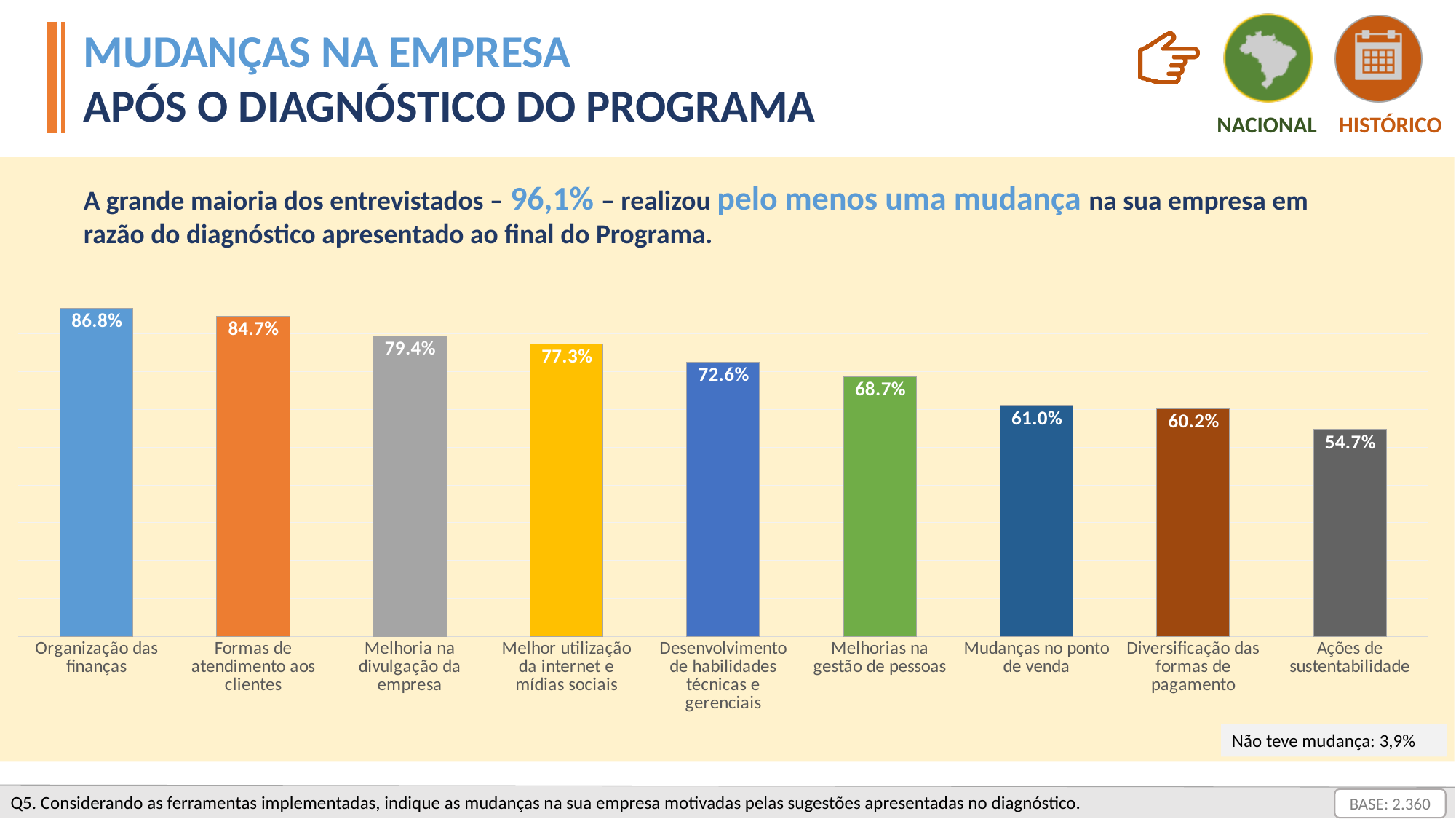
Which is larger: Melhor utilização da internet e mídias sociais or Desenvolvimento de habilidades técnicas e gerenciais? Melhor utilização da internet e mídias sociais What is the difference between Formas de atendimento aos clientes and Melhoria na divulgação da empresa? 5.3% Which category has the lowest value? Ações de sustentabilidade How many categories are shown in the bar chart? 9 Which category has the highest value? Organização das finanças What is the difference between Mudanças no ponto de venda and Ações de sustentabilidade? 6.3% What is the value for Melhorias na gestão de pessoas? 68.7% Do the values rise or fall from left to right across the categories? Fall What is the value for Organização das finanças? 86.8% What percentage of respondents reported no change (Não teve mudança)? 3,9% What kind of chart is shown on the slide? Bar chart What is the value for Diversificação das formas de pagamento? 60.2%